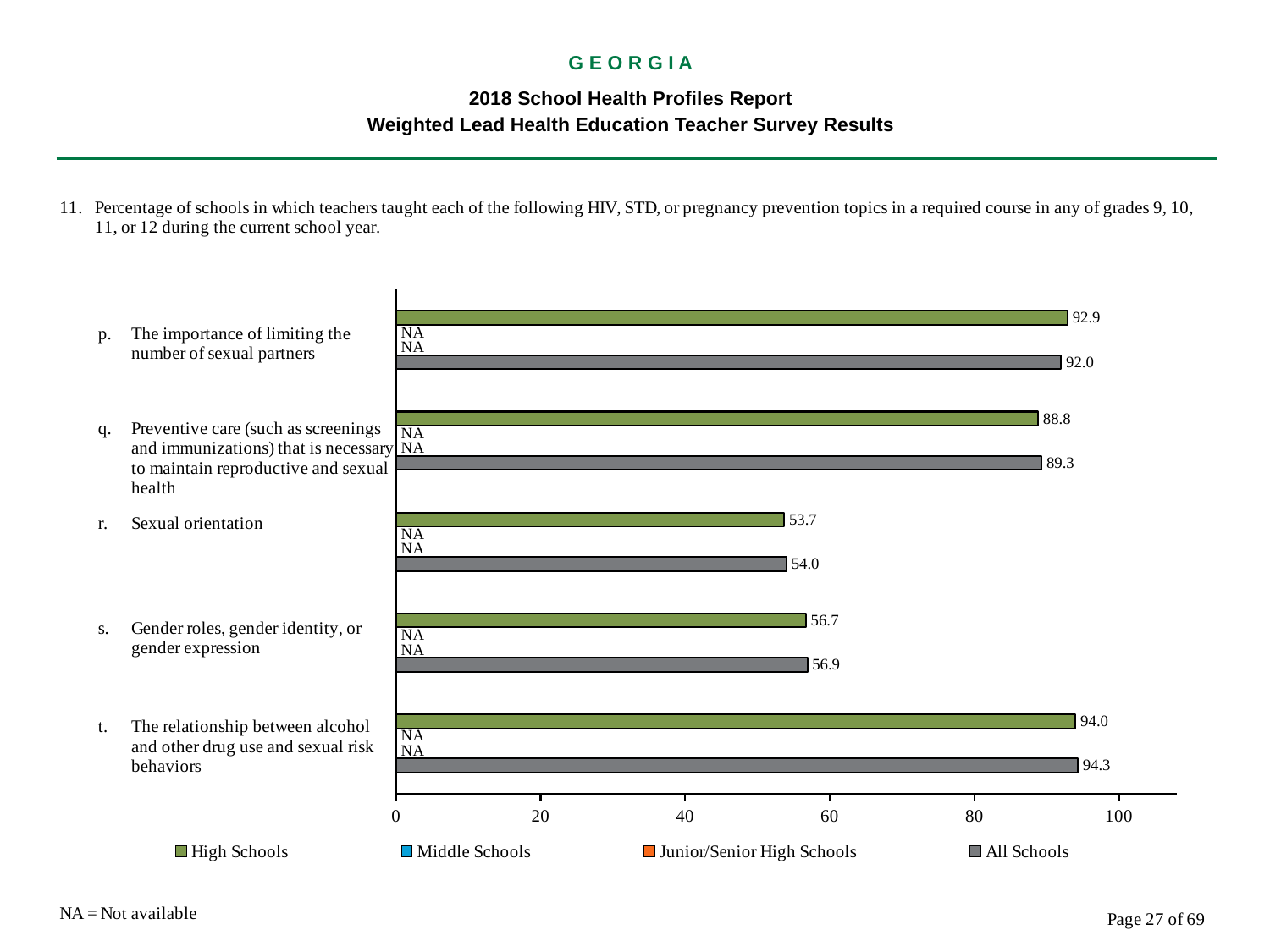
How many series does the legend list? 4 What is the High Schools value for 'The importance of limiting the number of sexual partners'? 92.9 What is the difference between the High Schools and All Schools values for 'Preventive care (such as screenings and immunizations) that is necessary to maintain reproductive and sexual health'? 0.5 Which topic has the lowest All Schools value? Sexual orientation What is the All Schools value for 'The relationship between alcohol and other drug use and sexual risk behaviors'? 94.3 What is the All Schools value for 'Sexual orientation'? 54.0 What kind of chart is shown on the slide? Bar chart How many topics are listed on the chart? 5 What value is shown for Middle Schools for 'Sexual orientation'? NA Which is larger: the High Schools value for 'Sexual orientation' or the High Schools value for 'Gender roles, gender identity, or gender expression'? Gender roles, gender identity, or gender expression What is the High Schools value for 'Gender roles, gender identity, or gender expression'? 56.7 Which topic has the highest High Schools value? The relationship between alcohol and other drug use and sexual risk behaviors